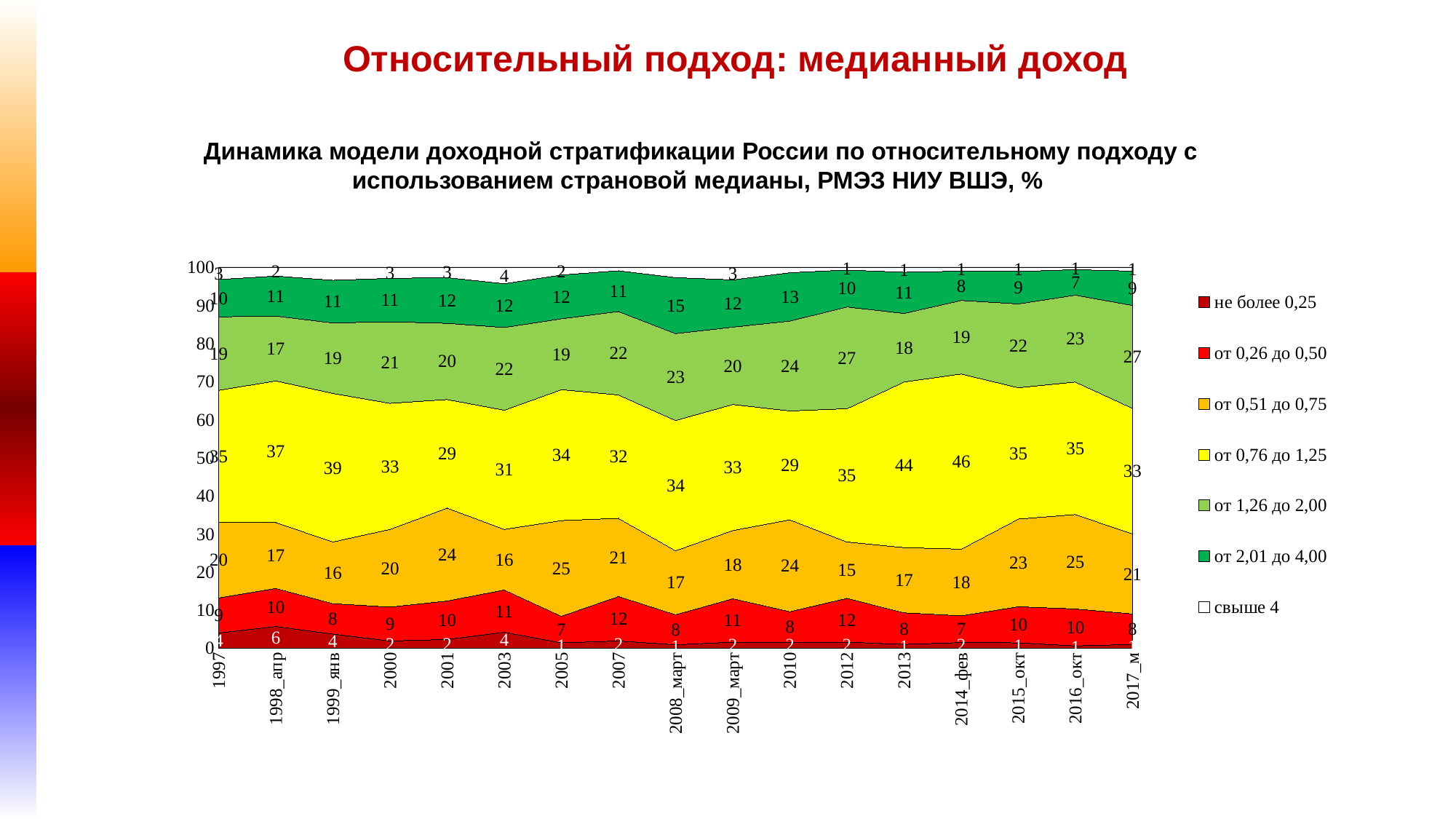
What is the value for the series 'от 0,51 до 0,75' in 2016_окт? 25 What is the value for the series 'не более 0,25' in 1998_апр? 6 How many series does the legend list? 7 Which legend entry is shown in yellow? от 0,76 до 1,25 What is the value for the series 'от 2,01 до 4,00' in 2008_март? 15 What is the difference between the 'от 0,76 до 1,25' values in 2014_фев and 2015_окт? 11 What is the value for the series 'от 0,76 до 1,25' in 2014_фев? 46 Which is larger for the series 'от 1,26 до 2,00': the value in 2012 or the value in 2013? 2012 What is the value for the series 'от 0,26 до 0,50' in 2007? 12 In which year does the series 'от 0,76 до 1,25' reach its highest value? 2014_фев How many time points are shown along the x axis? 17 What kind of chart is shown on the slide? stacked area chart